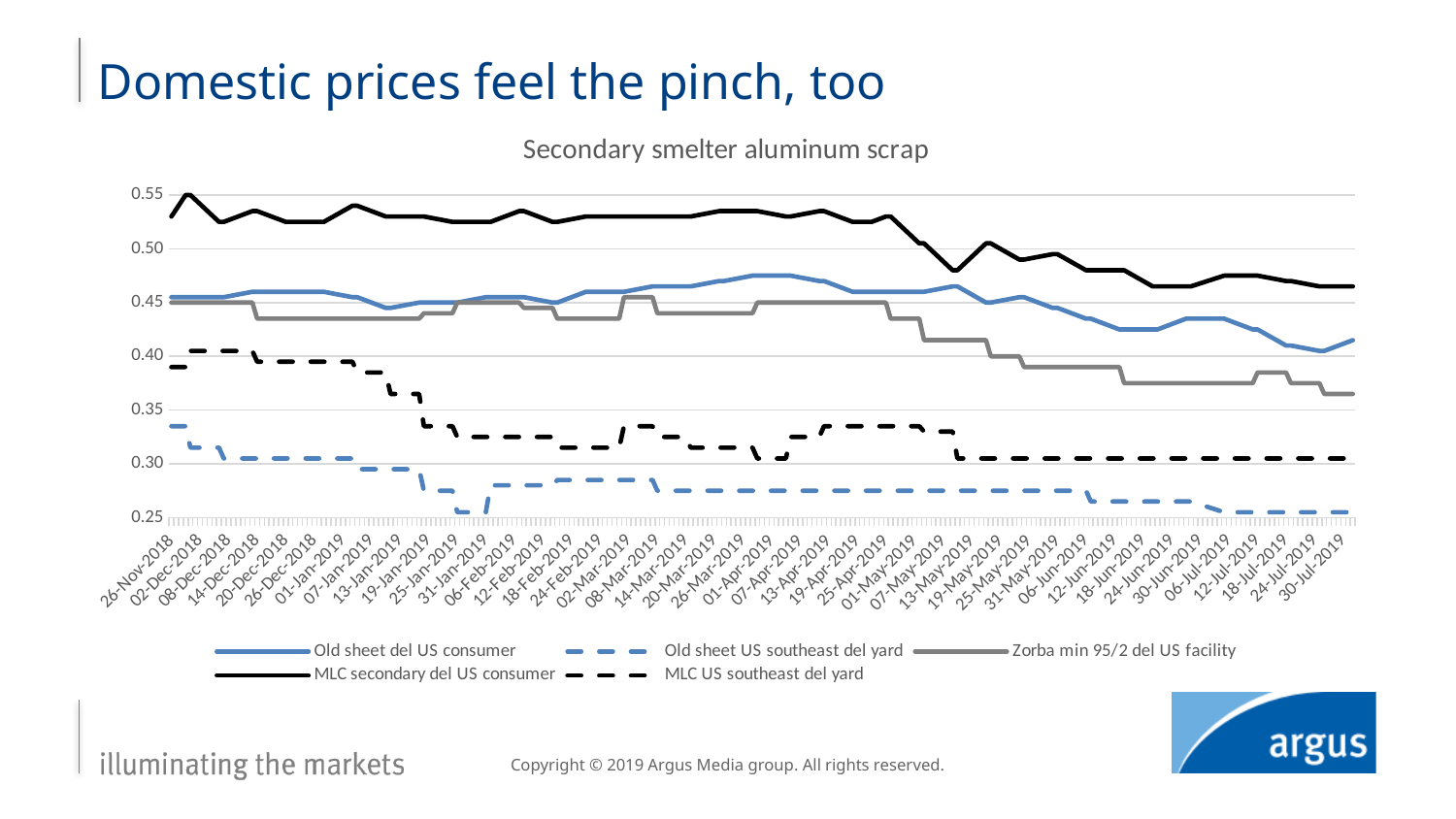
How many series does the legend list? 5 Is the value for Old sheet US southeast del yard at 30-Jul-2019 greater or less than 0.30? less Is the Old sheet US southeast del yard series drawn as a solid or a dashed line? dashed Which series has the lowest values across the whole period? Old sheet US southeast del yard What kind of chart is shown on the slide? line chart Does the Zorba min 95/2 del US facility series rise or fall over the period shown? fall Which series has the highest values across the whole period? MLC secondary del US consumer Is the value for Zorba min 95/2 del US facility at 30-Jul-2019 greater or less than 0.40? less What is the title of the chart? Secondary smelter aluminum scrap Is the value for MLC secondary del US consumer at 26-Nov-2018 greater or less than 0.50? greater Does the MLC secondary del US consumer series rise or fall from 26-Nov-2018 to 30-Jul-2019? fall At 30-Jul-2019, which is higher: MLC secondary del US consumer or Old sheet del US consumer? MLC secondary del US consumer